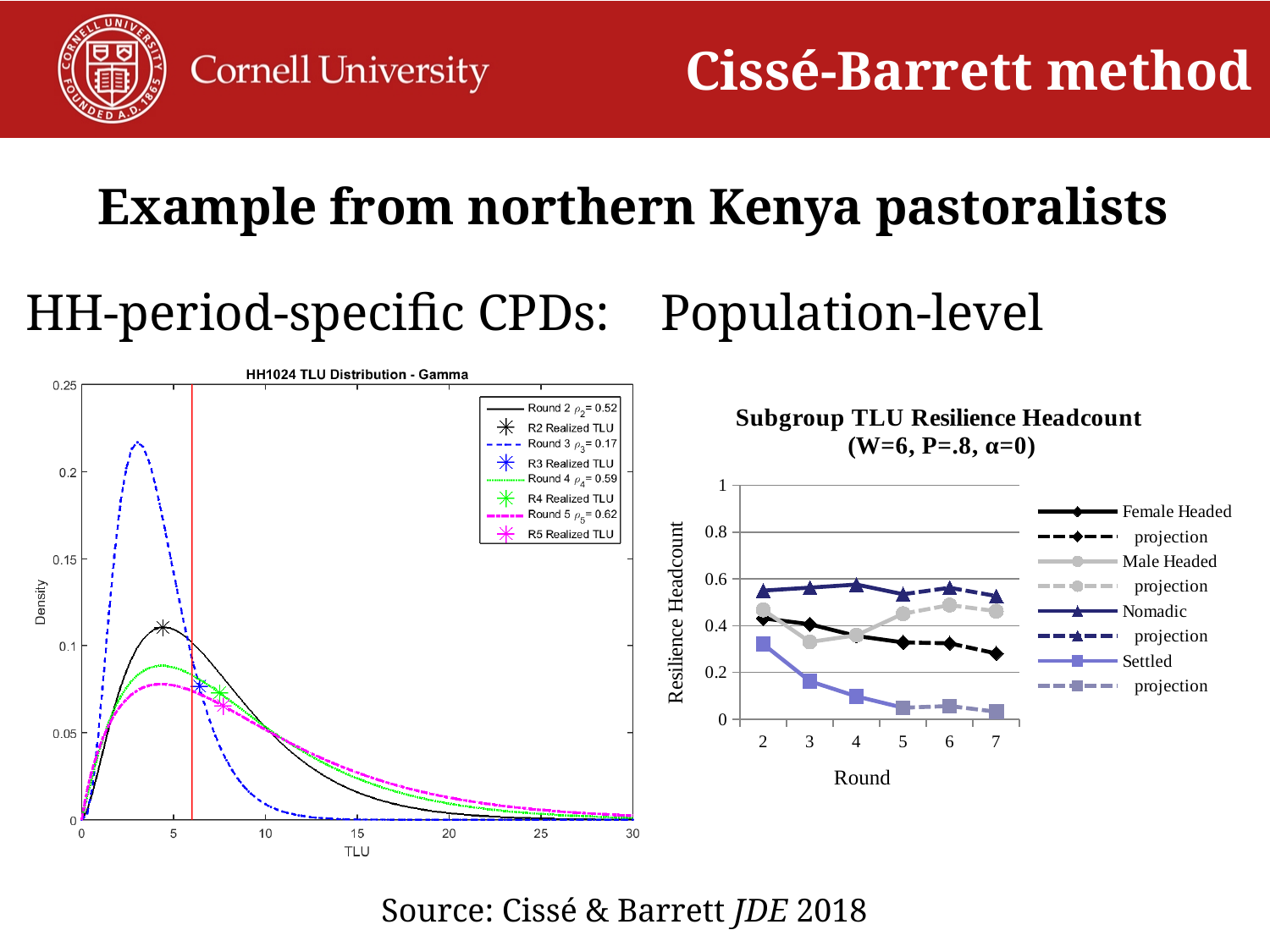
In the 'HH1024 TLU Distribution - Gamma' chart, which round's curve reaches the highest peak density? Round 3 In the 'Subgroup TLU Resilience Headcount' chart, is the Settled value at round 6 greater or less than 0.2? less What is the label of the x axis of the 'HH1024 TLU Distribution - Gamma' chart? TLU In the 'Subgroup TLU Resilience Headcount' chart, which subgroup has the highest resilience headcount at round 7? Nomadic In the 'Subgroup TLU Resilience Headcount' chart, how many rounds are shown on the x axis? 6 In the 'Subgroup TLU Resilience Headcount' chart, is the Nomadic value at round 4 greater or less than 0.4? greater In the 'Subgroup TLU Resilience Headcount' chart, which subgroup has the lowest resilience headcount at round 5? Settled In the 'Subgroup TLU Resilience Headcount' chart, at round 6, which is larger: Male Headed or Female Headed? Male Headed What kind of chart is the 'Subgroup TLU Resilience Headcount' chart on the right? line chart In the 'Subgroup TLU Resilience Headcount' chart, does the Settled series rise or fall from round 2 to round 7? fall In the 'Subgroup TLU Resilience Headcount' chart, how many entries does the legend list? 8 In the 'HH1024 TLU Distribution - Gamma' chart, what is the value of ρ3 shown in the legend for Round 3? 0.17